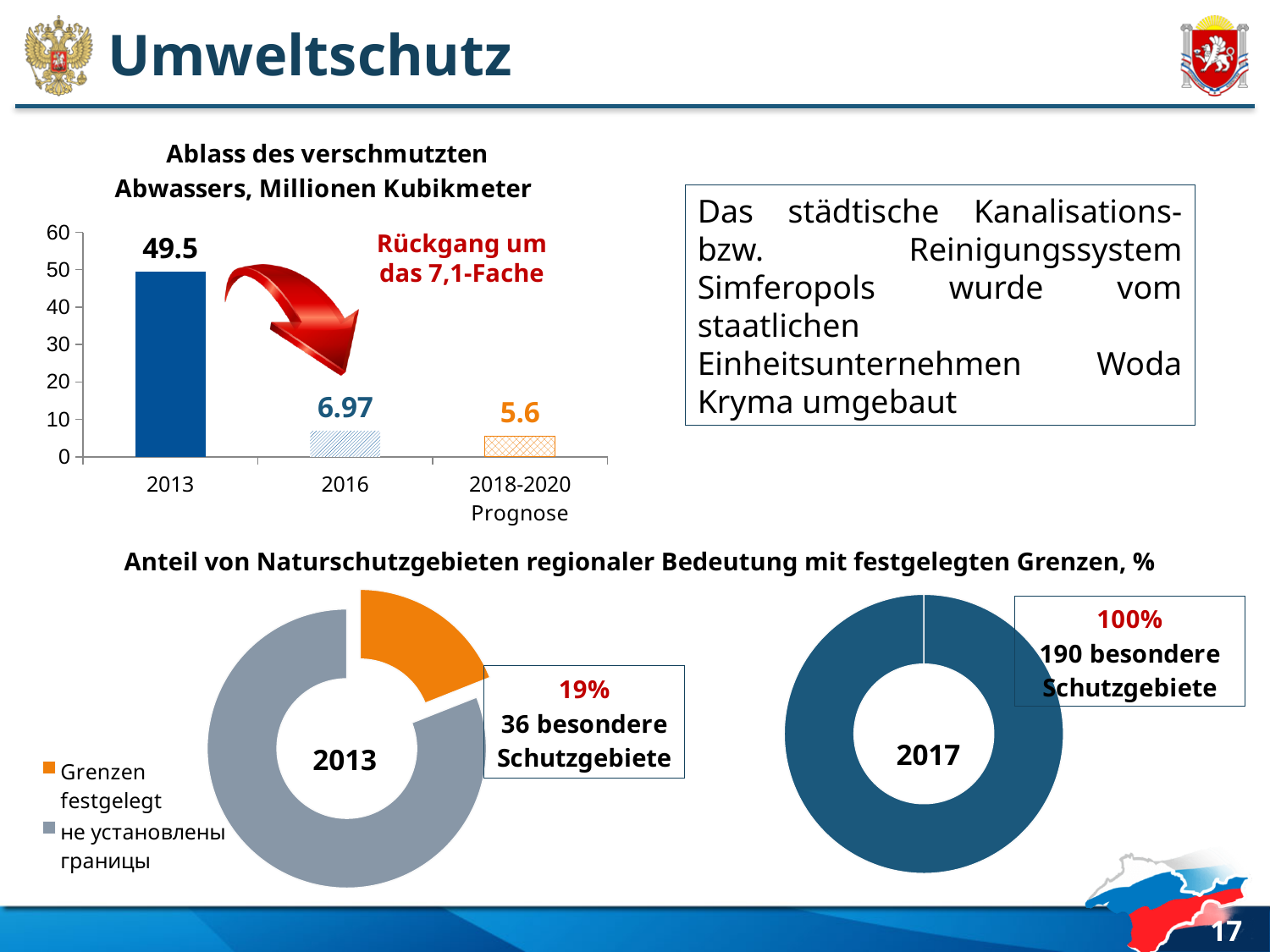
In the 2013 donut chart under 'Anteil von Naturschutzgebieten regionaler Bedeutung mit festgelegten Grenzen, %', what share is labelled for 'Grenzen festgelegt'? 19% In the bar chart 'Ablass des verschmutzten Abwassers, Millionen Kubikmeter', do the values rise or fall from 2013 to the 2018-2020 Prognose? fall In the bar chart 'Ablass des verschmutzten Abwassers, Millionen Kubikmeter', which category has the highest value? 2013 In the bar chart 'Ablass des verschmutzten Abwassers, Millionen Kubikmeter', what reduction factor is stated in the red annotation? Rückgang um das 7,1-Fache In the bar chart 'Ablass des verschmutzten Abwassers, Millionen Kubikmeter', what is the value for the 2018-2020 Prognose? 5.6 In the bar chart 'Ablass des verschmutzten Abwassers, Millionen Kubikmeter', what is the value for 2013? 49.5 What kind of chart is 'Ablass des verschmutzten Abwassers, Millionen Kubikmeter'? bar chart In the bar chart 'Ablass des verschmutzten Abwassers, Millionen Kubikmeter', what is the difference between the 2013 value and the 2016 value? 42.53 In the bar chart 'Ablass des verschmutzten Abwassers, Millionen Kubikmeter', which category has the lowest value? 2018-2020 Prognose In the 2017 donut chart under 'Anteil von Naturschutzgebieten regionaler Bedeutung mit festgelegten Grenzen, %', what share is labelled? 100% In the bar chart 'Ablass des verschmutzten Abwassers, Millionen Kubikmeter', what is the value for 2016? 6.97 In the bar chart 'Ablass des verschmutzten Abwassers, Millionen Kubikmeter', how many categories are shown on the x axis? 3